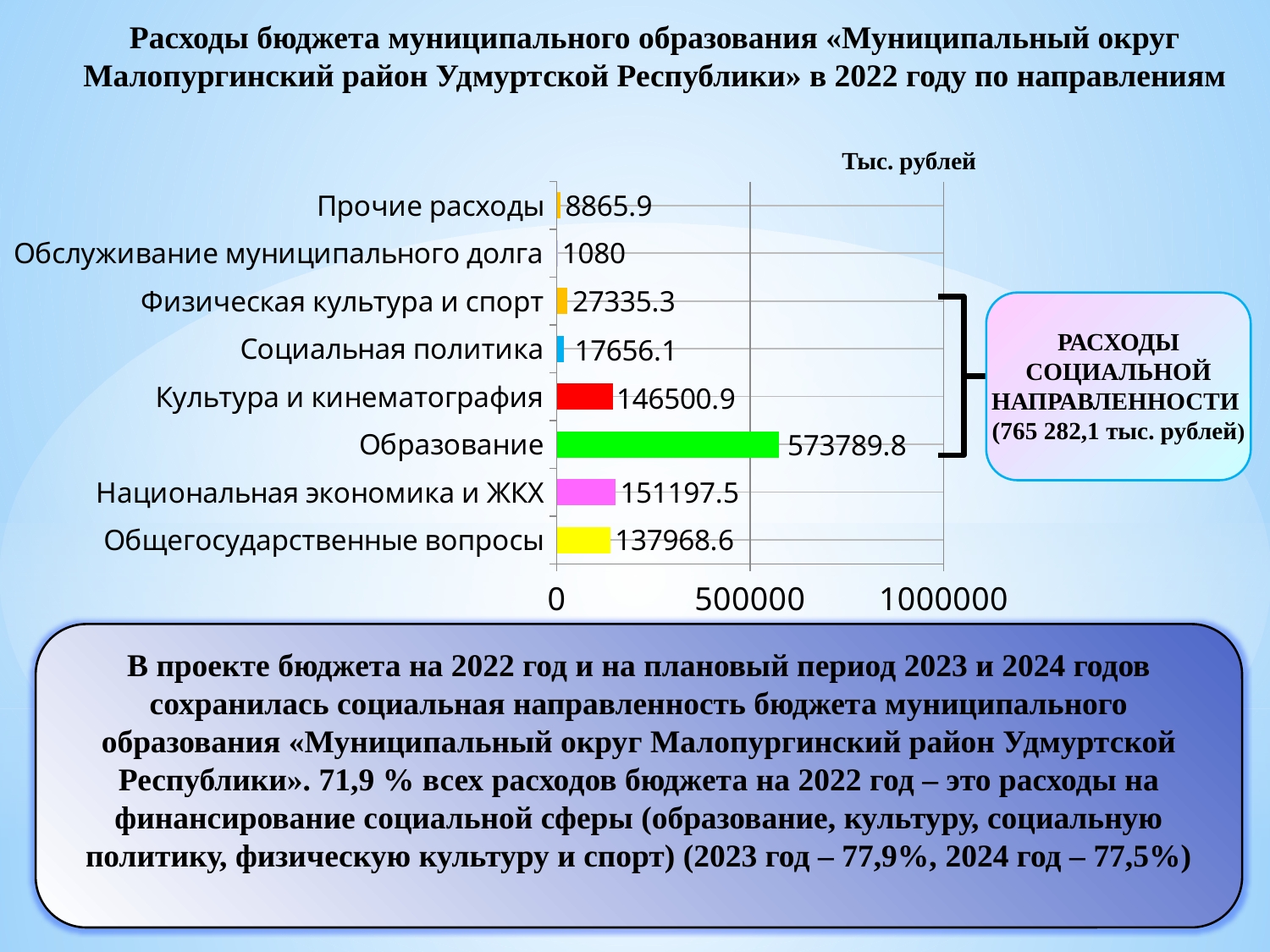
Which category has the lowest value? Обслуживание муниципального долга What is the difference between Национальная экономика и ЖКХ and Культура и кинематография? 4696.6 What is the value for Обслуживание муниципального долга? 1080 What is the value for Социальная политика? 17656.1 What is the value for Образование? 573789.8 What kind of chart is shown on the slide? bar chart What is the value for Культура и кинематография? 146500.9 Is the value for Образование greater or less than 500000? greater Which category has the highest value? Образование What is the difference between Физическая культура и спорт and Социальная политика? 9679.2 How many categories are shown in the chart? 8 Which is larger, Национальная экономика и ЖКХ or Общегосударственные вопросы? Национальная экономика и ЖКХ